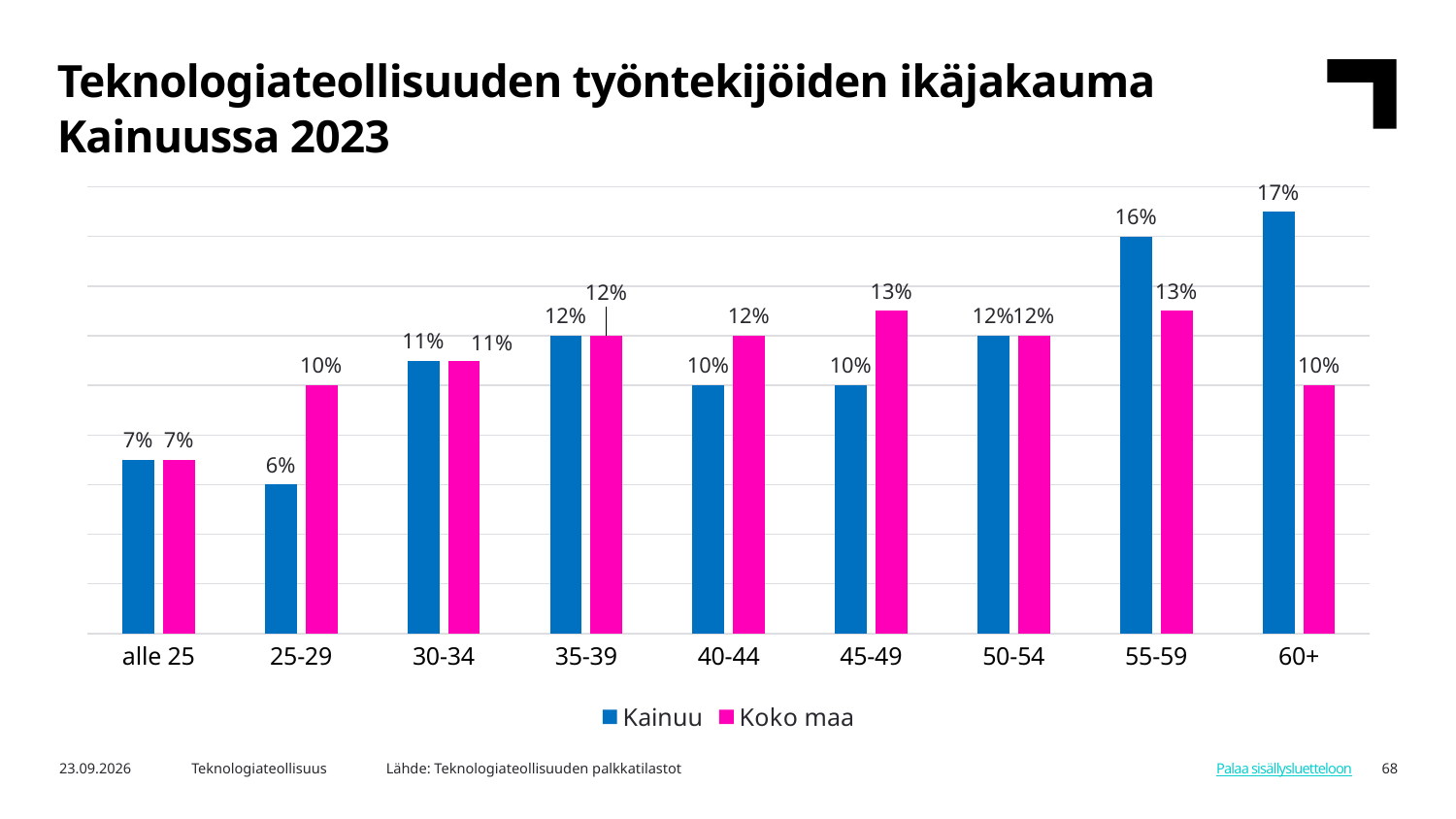
How many series does the legend list? 2 What kind of chart is shown on the slide? Bar chart Which age group has the highest Kainuu value? 60+ Which age group has the lowest Kainuu value? 25-29 What is the Kainuu value for the 60+ age group? 17% For the 25-29 age group, which is larger: Kainuu or Koko maa? Koko maa Which age group has the lowest Koko maa value? alle 25 What is the difference between the Kainuu and Koko maa values for the 60+ age group? 7 percentage points What is the Kainuu value for the 25-29 age group? 6% For the 55-59 age group, which is larger: Kainuu or Koko maa? Kainuu How many age groups are shown on the x axis? 9 What is the Koko maa value for the 45-49 age group? 13%